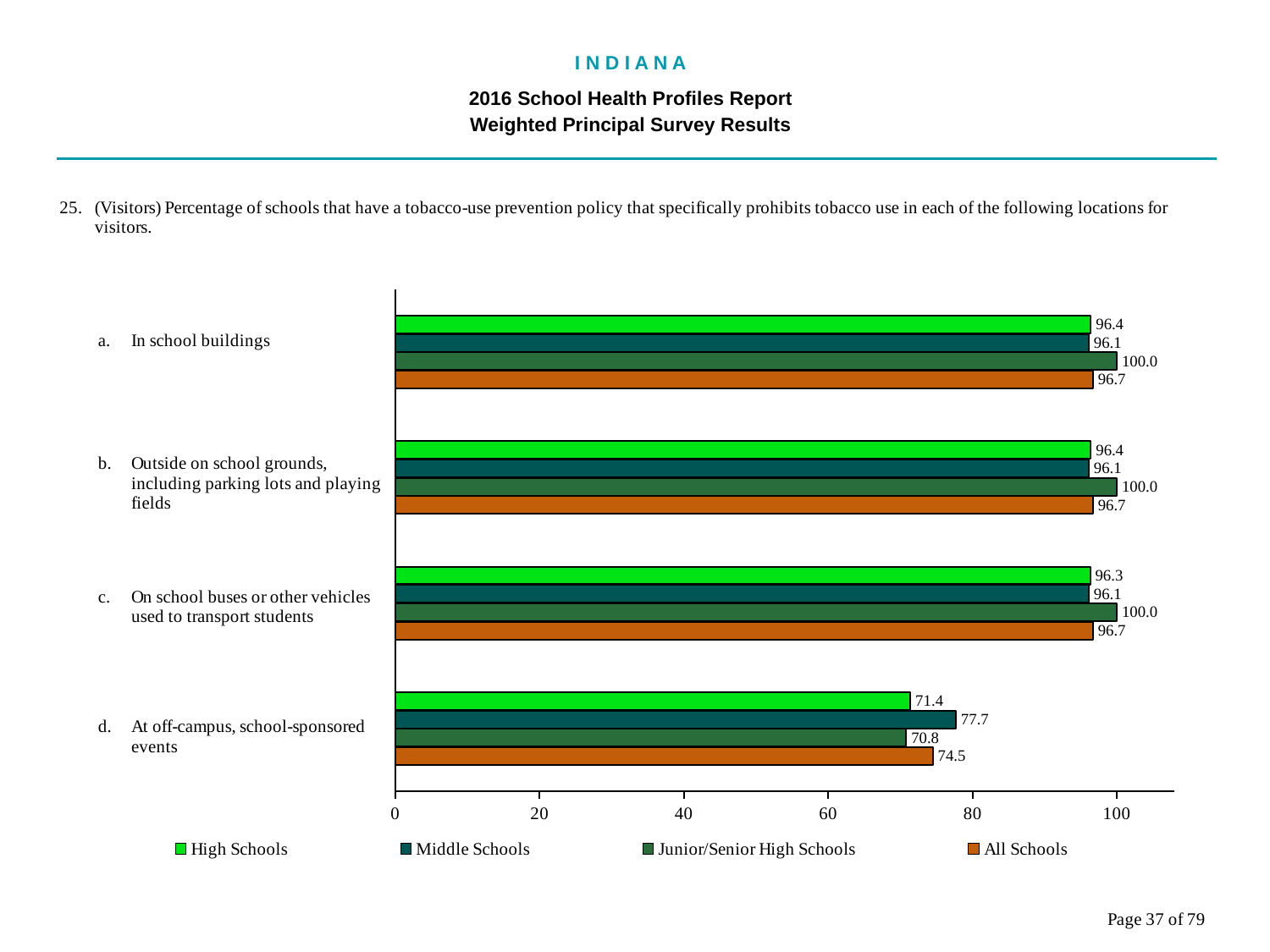
Is the value for Junior/Senior High Schools for 'At off-campus, school-sponsored events' greater or less than 80? less Which series has the highest value for 'At off-campus, school-sponsored events'? Middle Schools Which series has the lowest value for 'At off-campus, school-sponsored events'? Junior/Senior High Schools Is the All Schools value for 'At off-campus, school-sponsored events' larger than the High Schools value for the same category? Yes What is the value for Middle Schools for 'At off-campus, school-sponsored events'? 77.7 What is the value for High Schools for 'At off-campus, school-sponsored events'? 71.4 How many location categories are shown in the chart? 4 What is the value for Junior/Senior High Schools for 'In school buildings'? 100.0 What is the difference between the Middle Schools and High Schools values for 'At off-campus, school-sponsored events'? 6.3 What kind of chart is shown on the slide? Bar chart How many series does the legend list? 4 What is the value for All Schools for 'On school buses or other vehicles used to transport students'? 96.7